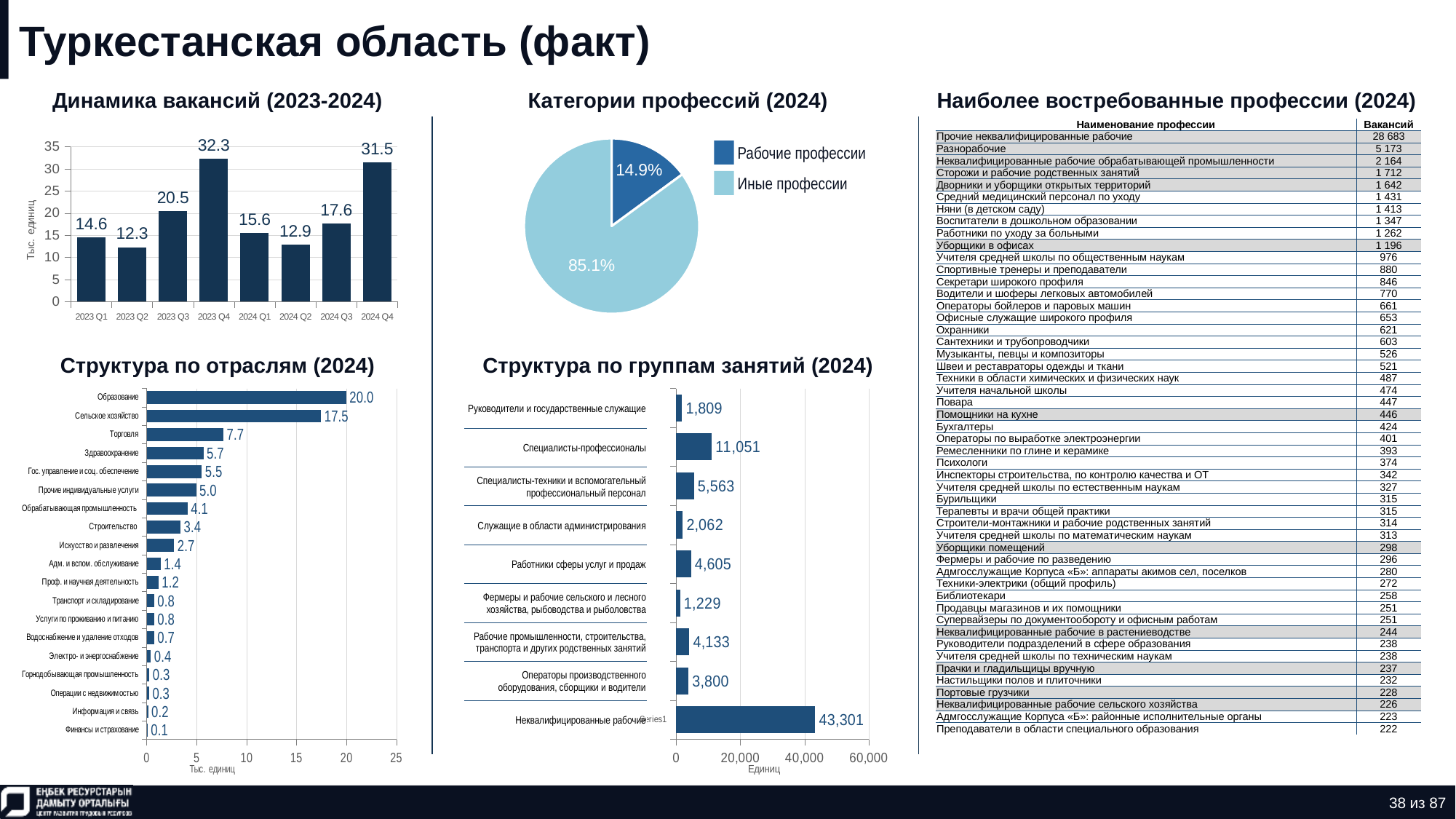
In the chart 'Категории профессий (2024)', what share does 'Рабочие профессии' have? 14.9% What kind of chart is 'Категории профессий (2024)'? Pie chart In the chart 'Структура по отраслям (2024)', which is larger: 'Здравоохранение' or 'Строительство'? Здравоохранение In the chart 'Структура по группам занятий (2024)', what is the value for 'Специалисты-профессионалы'? 11,051 In the chart 'Динамика вакансий (2023-2024)', which quarter has the lowest value? 2023 Q2 In the chart 'Структура по отраслям (2024)', which category has the highest value? Образование In the chart 'Структура по отраслям (2024)', what is the value for 'Торговля'? 7.7 In the chart 'Динамика вакансий (2023-2024)', what is the value for 2023 Q4? 32.3 In the chart 'Динамика вакансий (2023-2024)', how many quarters are plotted? 8 In the chart 'Динамика вакансий (2023-2024)', what is the difference between 2024 Q4 and 2024 Q3? 13.9 In the chart 'Категории профессий (2024)', how many entries does the legend list? 2 In the chart 'Структура по группам занятий (2024)', which category has the highest value? Неквалифицированные рабочие